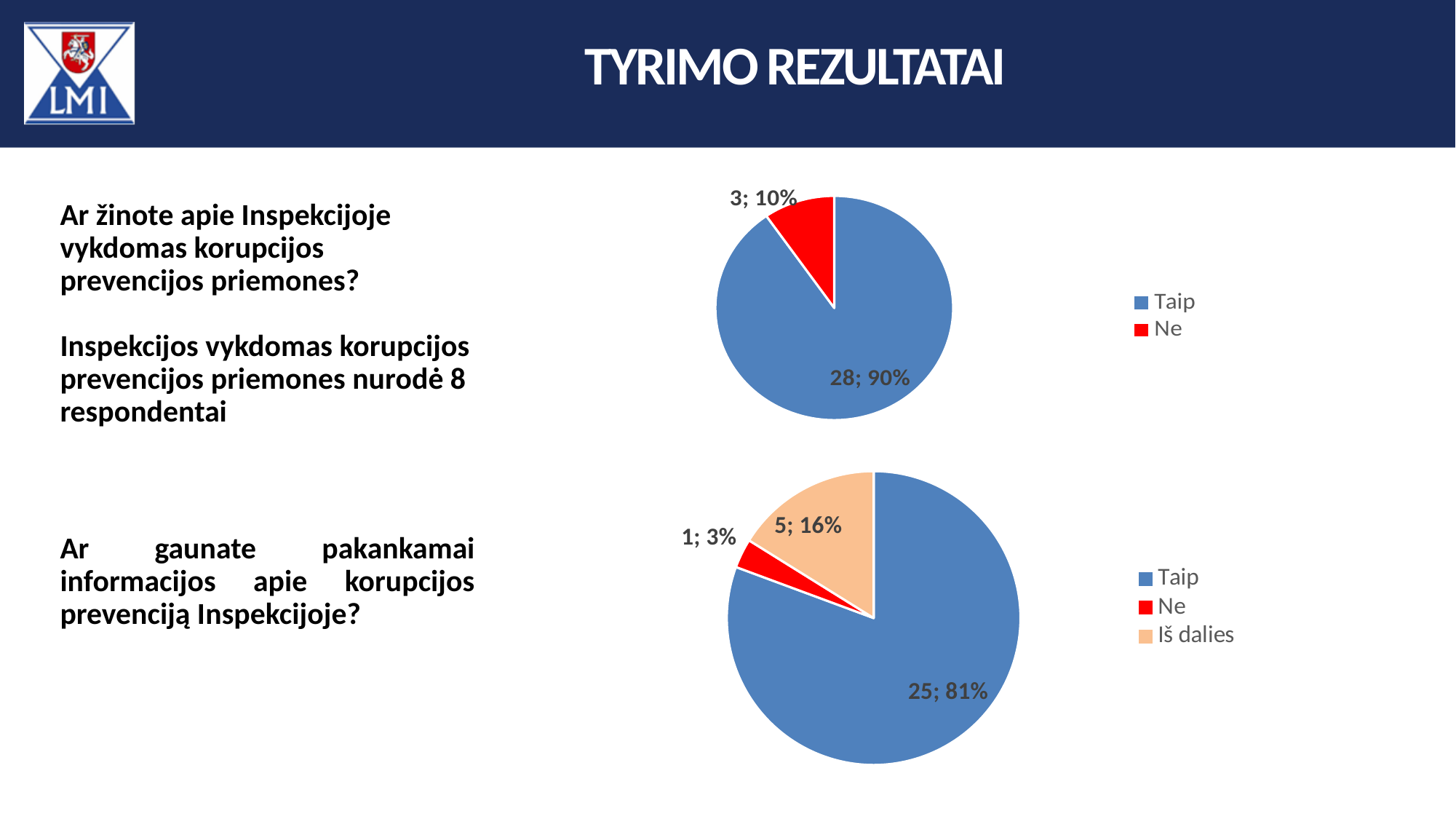
How many entries does the legend of the top pie chart list? 2 In the bottom pie chart, which is larger, Iš dalies or Ne? Iš dalies In the top pie chart, what share of the pie does Ne represent? 10% In the bottom pie chart, which category is the smallest? Ne In the bottom pie chart, what is the value shown for Iš dalies? 5; 16% In the top pie chart, what is the value shown for Ne? 3; 10% What type of chart is the bottom chart? Pie chart In the top pie chart, which category is the largest? Taip In the top pie chart, what is the difference in count between Taip and Ne? 25 In the top pie chart, what is the value shown for Taip? 28; 90% In the bottom pie chart, what is the value shown for Ne? 1; 3% In the bottom pie chart, what share of the pie does Taip represent? 81%